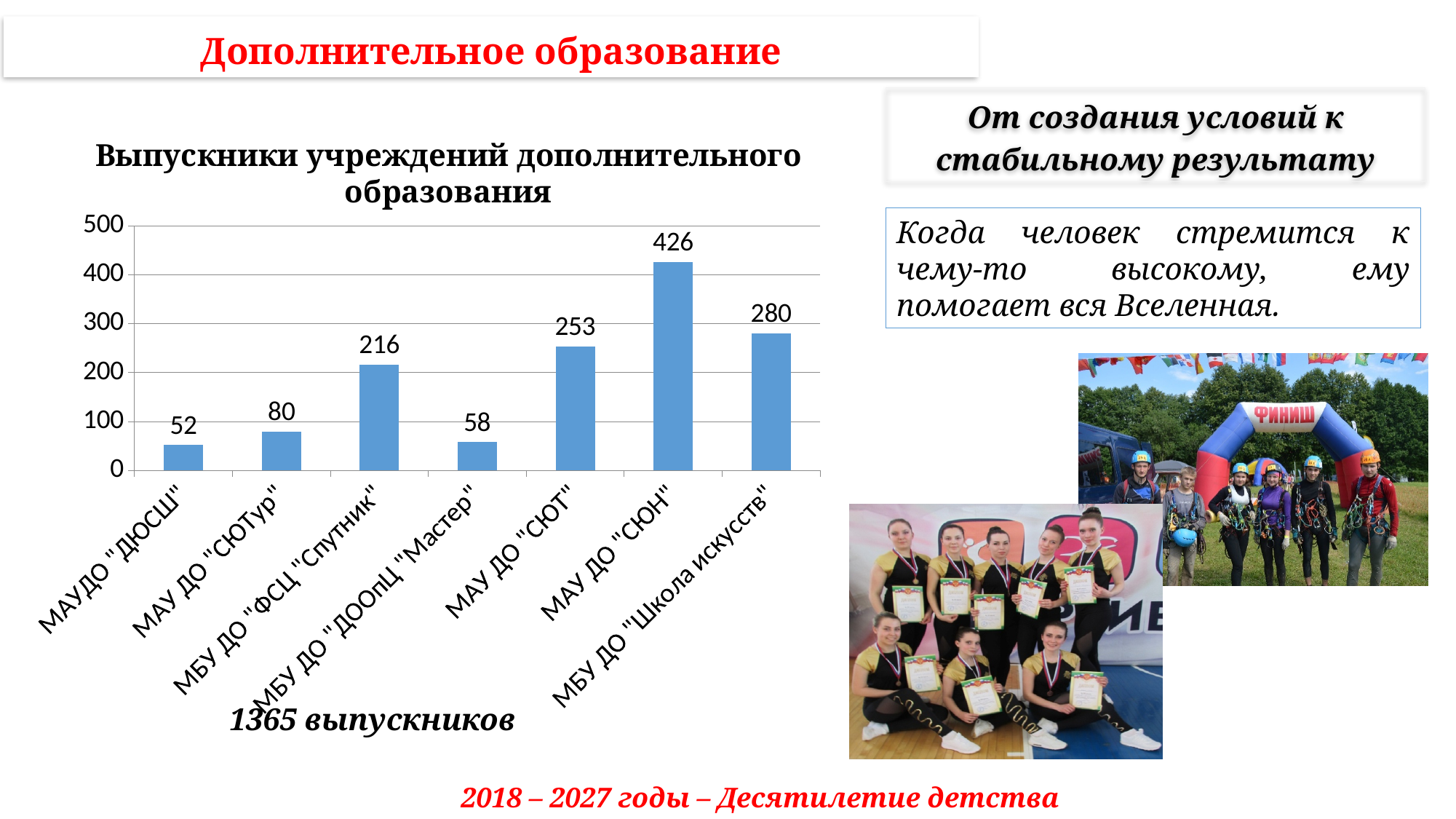
What is the title of the chart on the slide? Выпускники учреждений дополнительного образования Which has more graduates: МАУ ДО "СЮТур" or МБУ ДО "ДООПЦ "Мастер""? МАУ ДО "СЮТур" What is the value for МБУ ДО "Школа искусств"? 280 How many institutions (categories) are shown in the chart? 7 What is the total number of graduates stated below the chart? 1365 выпускников Is the value for МБУ ДО "Школа искусств" greater or less than 200? greater What type of chart is used to show the graduates of additional education institutions? bar chart What is the value for МАУ ДО "СЮН" in the chart "Выпускники учреждений дополнительного образования"? 426 Which institution has the highest number of graduates in the chart? МАУ ДО "СЮН" What is the difference between the values for МАУ ДО "СЮН" and МАУ ДО "СЮТ"? 173 Which institution has the lowest number of graduates in the chart? МАУДО "ДЮСШ" How many graduates does the chart show for МБУ ДО "ФСЦ "Спутник""? 216